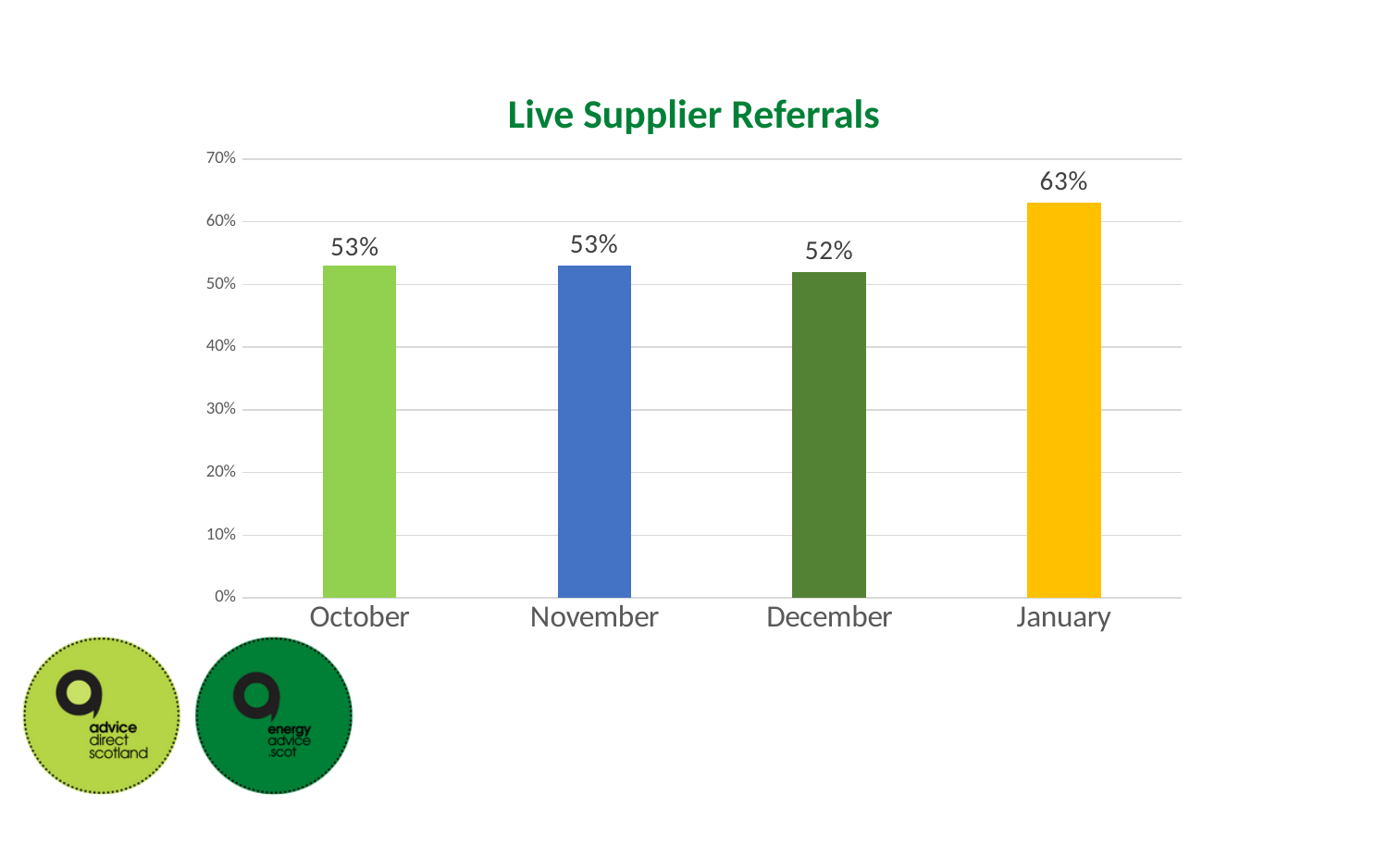
Is the value for January greater or less than 60%? greater What is the title of the chart? Live Supplier Referrals What is the value for December? 52% What is the value for January? 63% Which month has the lowest value? December How many months are shown on the chart? 4 Which month has the highest value? January What is the value for October? 53% What is the value for November? 53% Which is larger, the value for January or the value for October? January What kind of chart is this? Bar chart What is the difference between the values for January and December? 11%